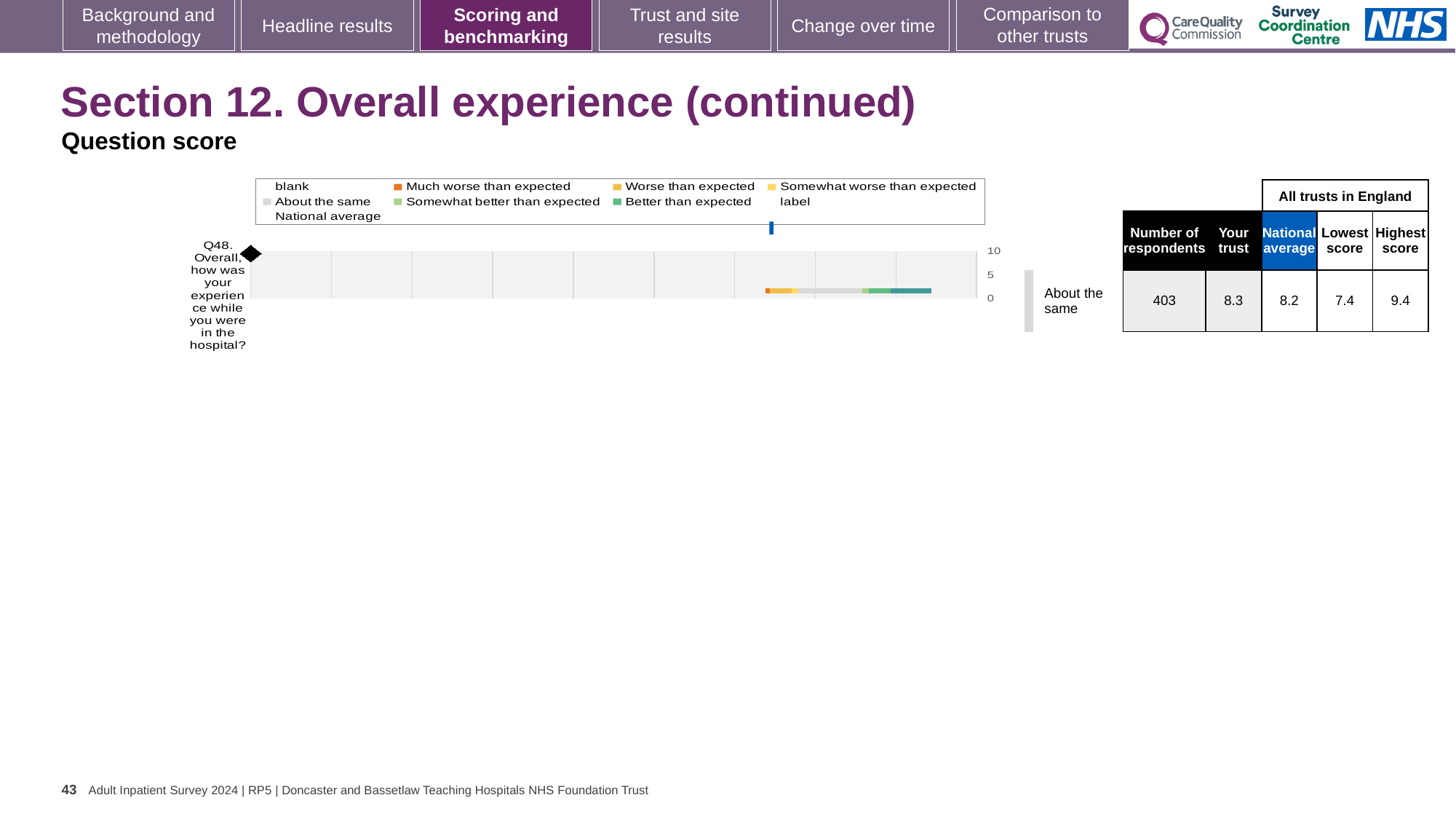
How many respondents answered Q48? 403 What kind of chart is used to show the Q48 question score? bar chart What benchmark category is the trust's Q48 result assigned to? About the same What colour represents 'Much worse than expected' in the legend? orange By how much does the 'Your trust' score exceed the national average for Q48? 0.1 What is the difference between the highest score and the lowest score for Q48? 2.0 What is the highest score among all trusts in England for Q48? 9.4 What is the 'Your trust' score for Q48 (Overall, how was your experience while you were in the hospital?)? 8.3 What is the national average score for Q48? 8.2 What is the lowest score among all trusts in England for Q48? 7.4 How many questions (categories) are plotted in the chart? 1 Which is larger for Q48, the 'Your trust' score or the national average? Your trust